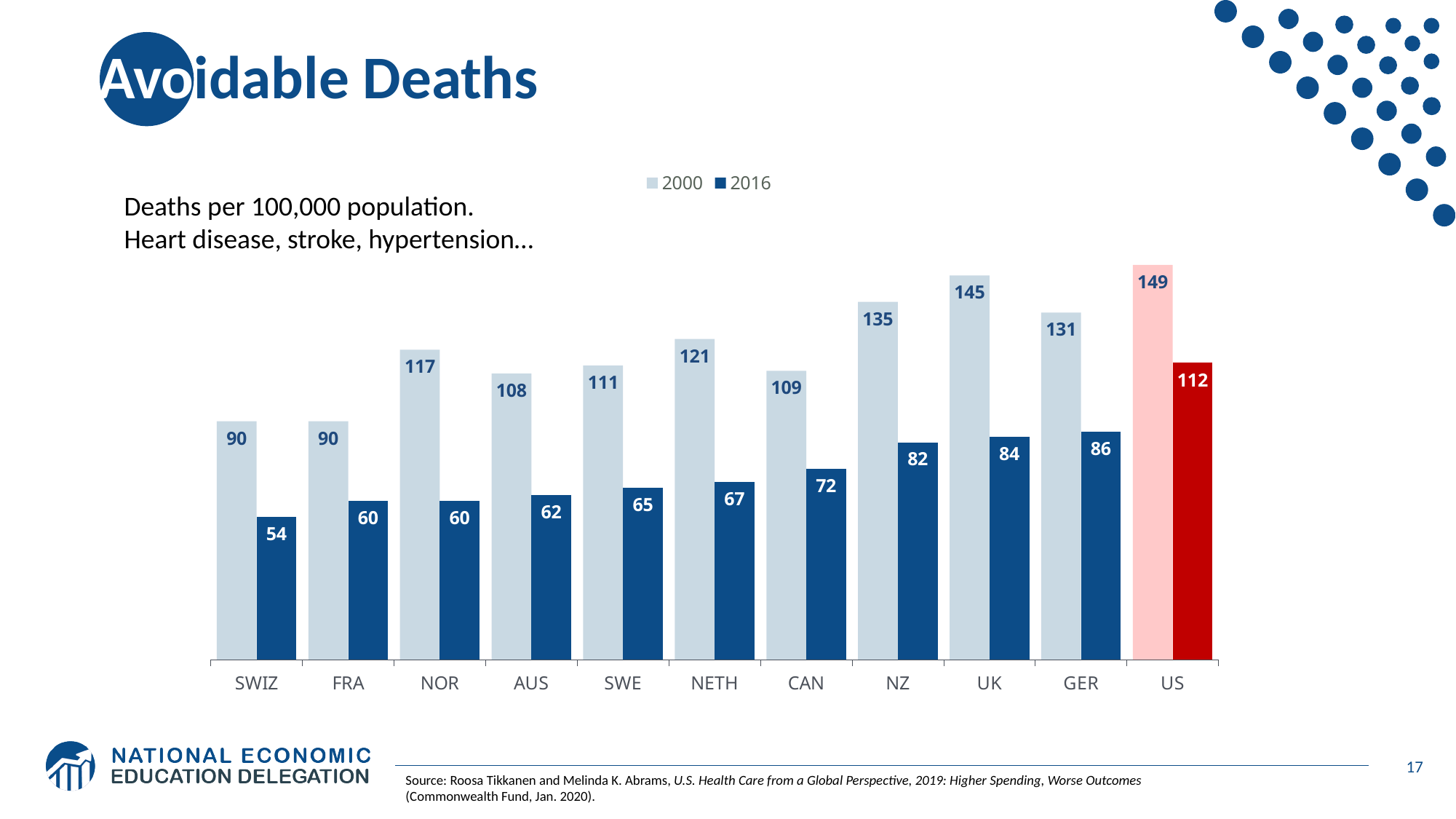
How many countries are shown on the x axis? 11 How many series does the legend list? 2 Which is larger, the 2016 value for Germany (GER) or the 2016 value for the UK? GER Which country had the lowest value in 2016? SWIZ Which years are listed in the chart legend? 2000 and 2016 What was the value for the US in 2000? 149 What kind of chart is shown on the slide? Bar chart Which country had the highest value in 2016? US What is the difference between the US values for 2000 and 2016? 37 What was the value for the UK in 2000? 145 Do the 2016 values generally rise or fall moving from SWIZ to US along the x axis? Rise What was the value for Switzerland (SWIZ) in 2016? 54